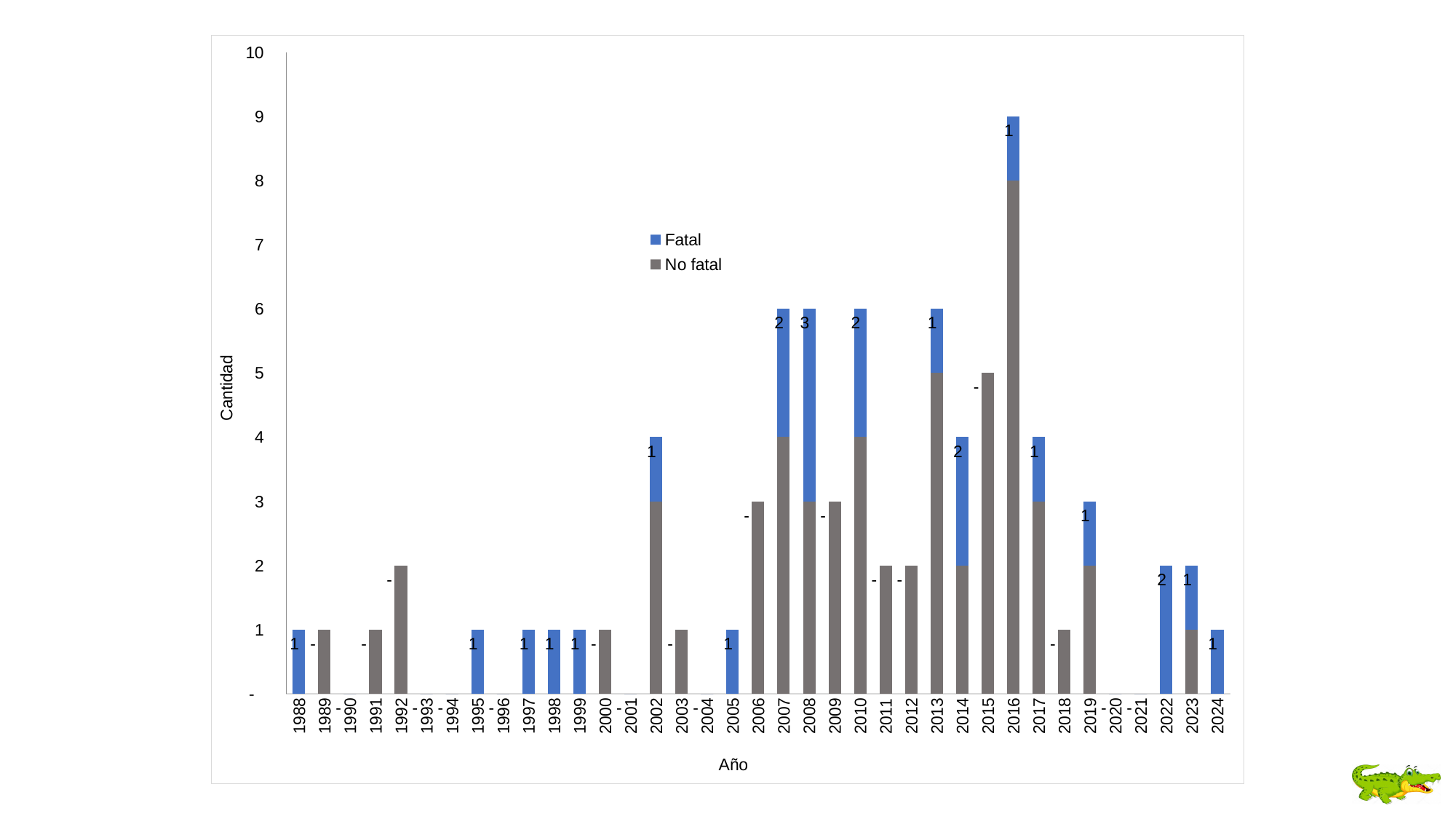
Which is larger, the Fatal value for 2007 or the Fatal value for 2013? 2007 Which year has the tallest stacked bar overall? 2016 What kind of chart is shown on the slide? Stacked bar chart Is the total bar height for 2016 greater or less than 8? greater What is the Fatal value for 2016? 1 What is the Fatal value for 2022? 2 What is the difference between the Fatal value for 2008 and the Fatal value for 2017? 2 Which year has the highest Fatal value? 2008 Is the total bar height for 2015 greater or less than 4? greater What is the label on the vertical axis? Cantidad What is the Fatal value for 2008? 3 How many series does the legend list? 2